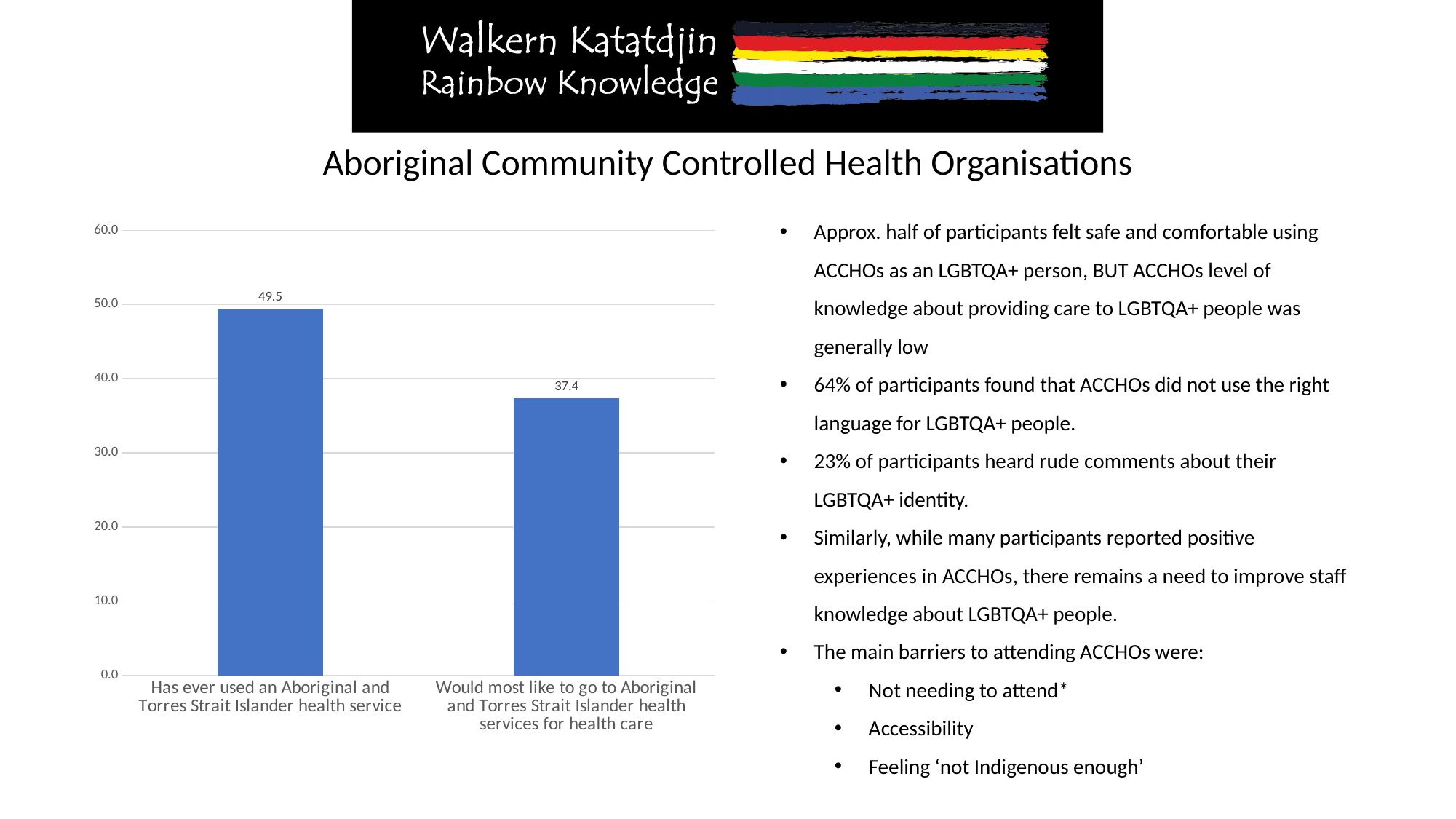
What is the value for 'Would most like to go to Aboriginal and Torres Strait Islander health services for health care'? 37.4 Which category has the lowest value? Would most like to go to Aboriginal and Torres Strait Islander health services for health care Is the value for 'Would most like to go to Aboriginal and Torres Strait Islander health services for health care' greater or less than 40.0? less Is the value for 'Has ever used an Aboriginal and Torres Strait Islander health service' greater or less than 40.0? greater What is the value for 'Has ever used an Aboriginal and Torres Strait Islander health service'? 49.5 What is the difference between the value for 'Has ever used an Aboriginal and Torres Strait Islander health service' and the value for 'Would most like to go to Aboriginal and Torres Strait Islander health services for health care'? 12.1 Which is larger: the value for 'Has ever used an Aboriginal and Torres Strait Islander health service' or the value for 'Would most like to go to Aboriginal and Torres Strait Islander health services for health care'? Has ever used an Aboriginal and Torres Strait Islander health service Which category has the highest value? Has ever used an Aboriginal and Torres Strait Islander health service What is the maximum value shown on the chart's vertical axis? 60.0 How many categories are shown in the chart? 2 What kind of chart is shown on the slide? bar chart Do the values rise or fall from left to right across the categories? fall